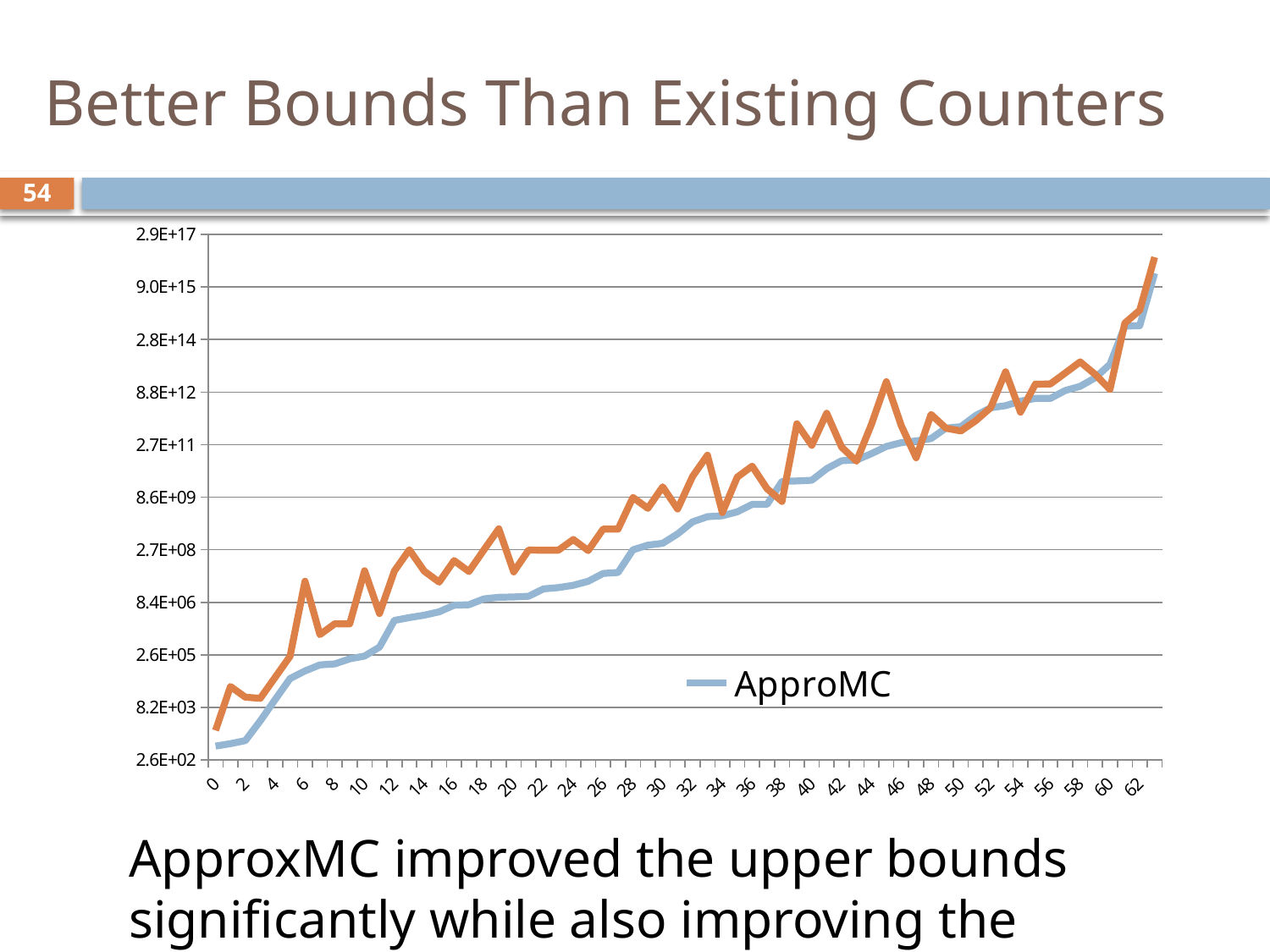
Is the ApproMC value at x = 30 greater or less than 8.6E+09? less What is the highest value label shown on the y axis of the chart? 2.9E+17 Is the ApproMC value at x = 10 greater or less than 8.4E+06? less Which is larger for ApproMC, the value at x = 20 or the value at x = 50? x = 50 How many series does the chart legend list? 1 Is the ApproMC value at x = 62 greater or less than 2.8E+14? greater Do the ApproMC values generally rise or fall as the x axis increases from 0 to 62? rise At which x-axis position is the ApproMC value lowest? 0 What is the name of the series listed in the chart legend? ApproMC What kind of chart is shown on the slide? line chart What colour is the ApproMC line in the chart? blue